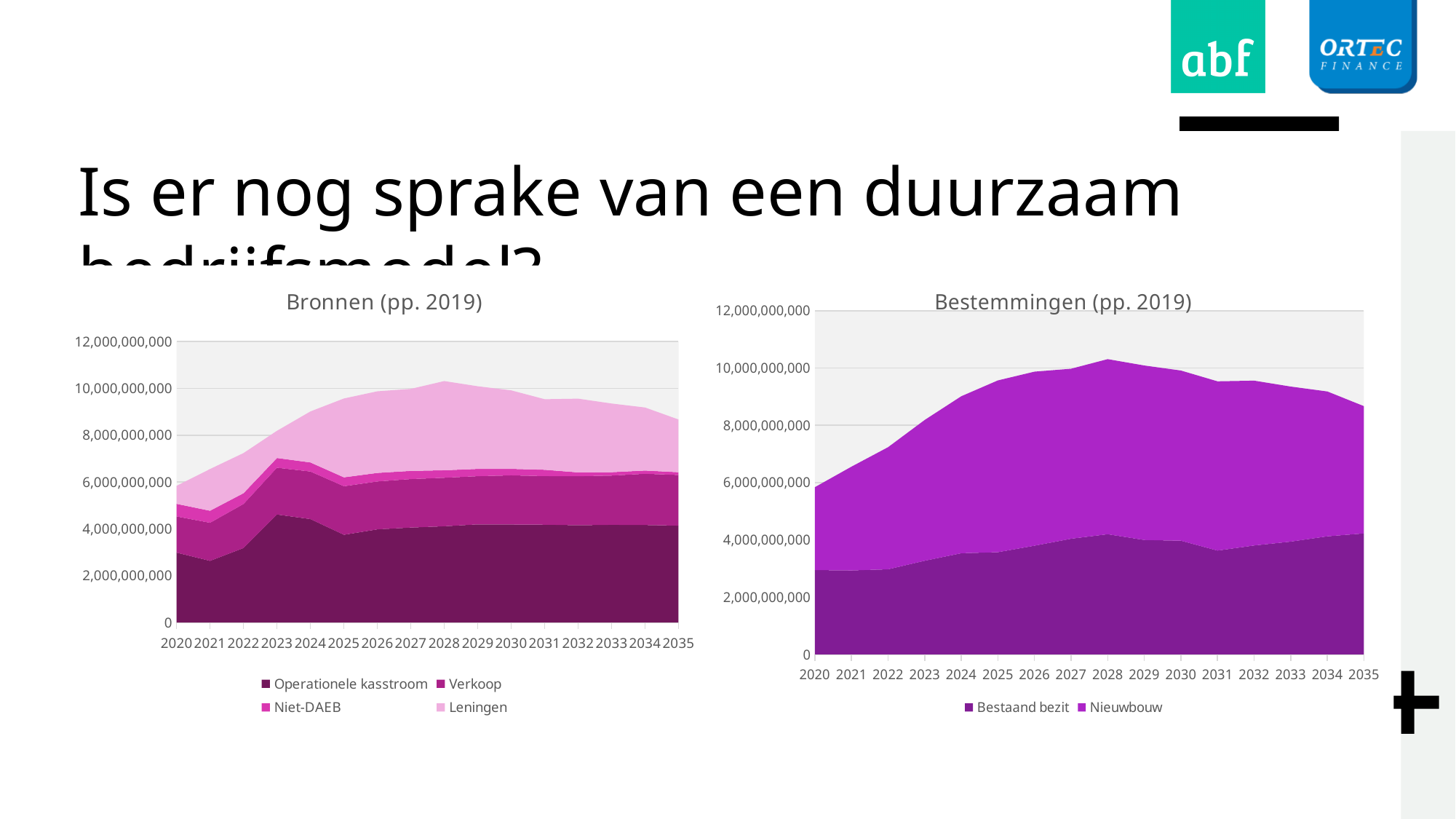
What kind of chart is the "Bronnen (pp. 2019)" chart? Stacked area chart In the "Bestemmingen (pp. 2019)" chart, does the total of all series rise or fall from 2028 to 2035? fall In the "Bestemmingen (pp. 2019)" chart, is the total for 2035 greater or less than 8,000,000,000? greater Which series are listed in the legend of the "Bestemmingen (pp. 2019)" chart? Bestaand bezit and Nieuwbouw In the "Bronnen (pp. 2019)" chart, which year has the lowest total of all series? 2020 In the "Bronnen (pp. 2019)" chart, is the value for Operationele kasstroom in 2020 greater or less than 4,000,000,000? less How many series does the legend of the "Bronnen (pp. 2019)" chart list? 4 In the "Bronnen (pp. 2019)" chart, which year has the highest total of all series? 2028 In the "Bestemmingen (pp. 2019)" chart, which year has the highest total of all series? 2028 In the "Bestemmingen (pp. 2019)" chart, which year has the lowest total of all series? 2020 How many years are shown on the x axis of the "Bestemmingen (pp. 2019)" chart? 16 How many series does the legend of the "Bestemmingen (pp. 2019)" chart list? 2